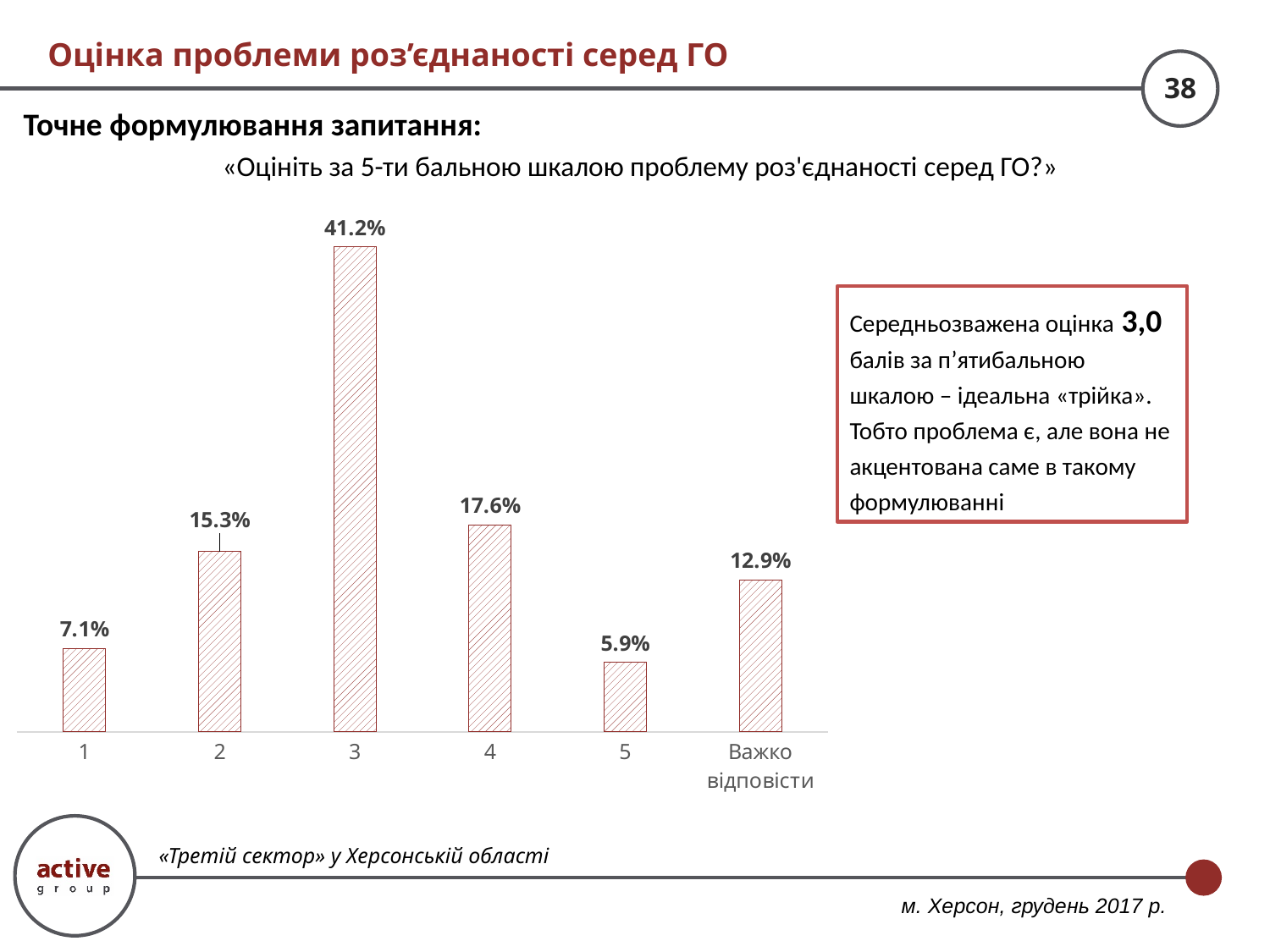
Which category has the lowest value? 5 What is the value for category 3? 41.2% What kind of chart is shown on the slide? bar chart Which is larger, the value for category 2 or the value for category 4? 4 What is the difference between the values for category 3 and category 4? 23.6% Which category has the highest value? 3 What weighted average score is stated in the text box next to the chart? 3,0 What is the difference between the values for category 2 and category 1? 8.2% Which is larger, the value for category 5 or the value for "Важко відповісти"? Важко відповісти What is the value for category 1? 7.1% How many categories are shown on the x axis? 6 What is the value for "Важко відповісти"? 12.9%